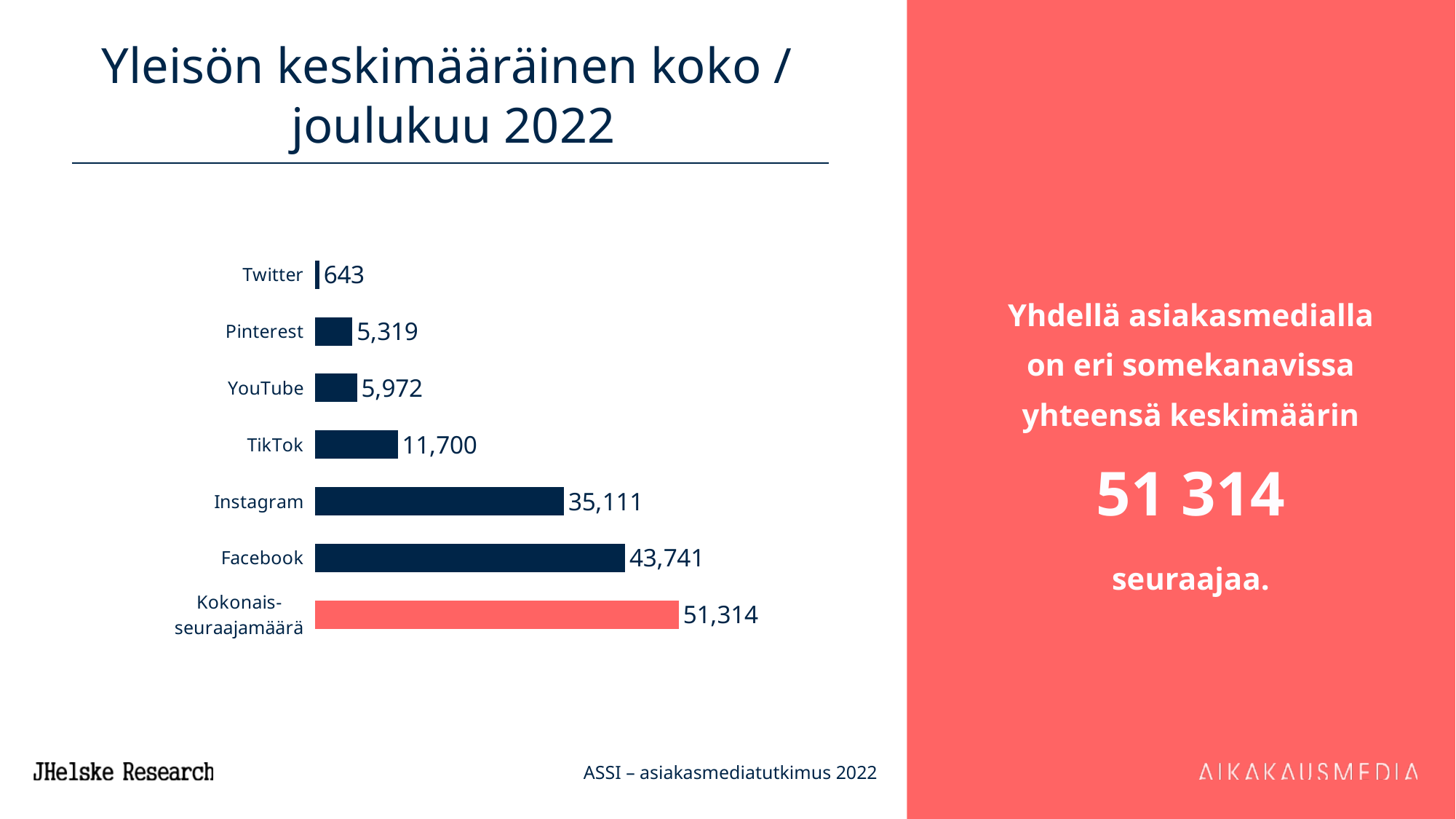
What is the value for Facebook? 43,741 What is the value for TikTok? 11,700 Which is larger, the value for Instagram or the value for TikTok? Instagram What is the value for Pinterest? 5,319 What is the difference between the values for Facebook and Instagram? 8,630 What kind of chart is shown on the slide? Bar chart What is the value for Kokonais-seuraajamäärä? 51,314 Which category has the lowest value? Twitter What is the difference between the values for YouTube and Pinterest? 653 What is the title of the chart? Yleisön keskimääräinen koko / joulukuu 2022 How many categories are shown in the chart? 7 Which category has the highest value? Kokonais-seuraajamäärä